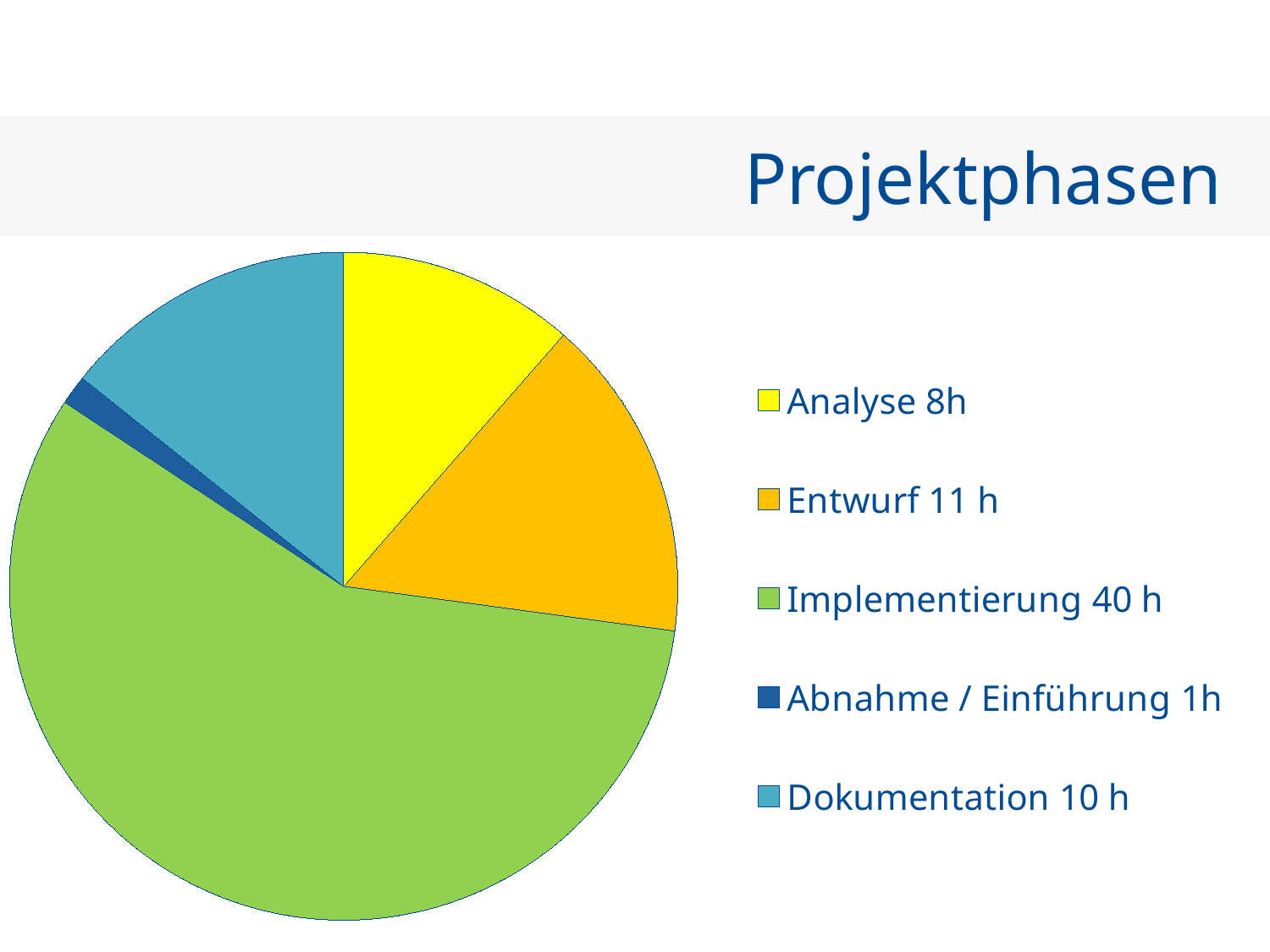
Which phase has more hours, Entwurf or Dokumentation? Entwurf How many hours are shown for Analyse? 8h How many hours are shown for Abnahme / Einführung? 1h What kind of chart is shown on the slide? Pie chart What colour is the slice for Dokumentation? Light blue How many hours are shown for Entwurf? 11 h What is the difference in hours between Implementierung and Entwurf? 29 h How many slices does the pie chart have? 5 What is the title of the slide with the pie chart? Projektphasen Which project phase has the smallest slice of the pie? Abnahme / Einführung Which project phase has the largest slice of the pie? Implementierung How many hours are shown for Implementierung? 40 h